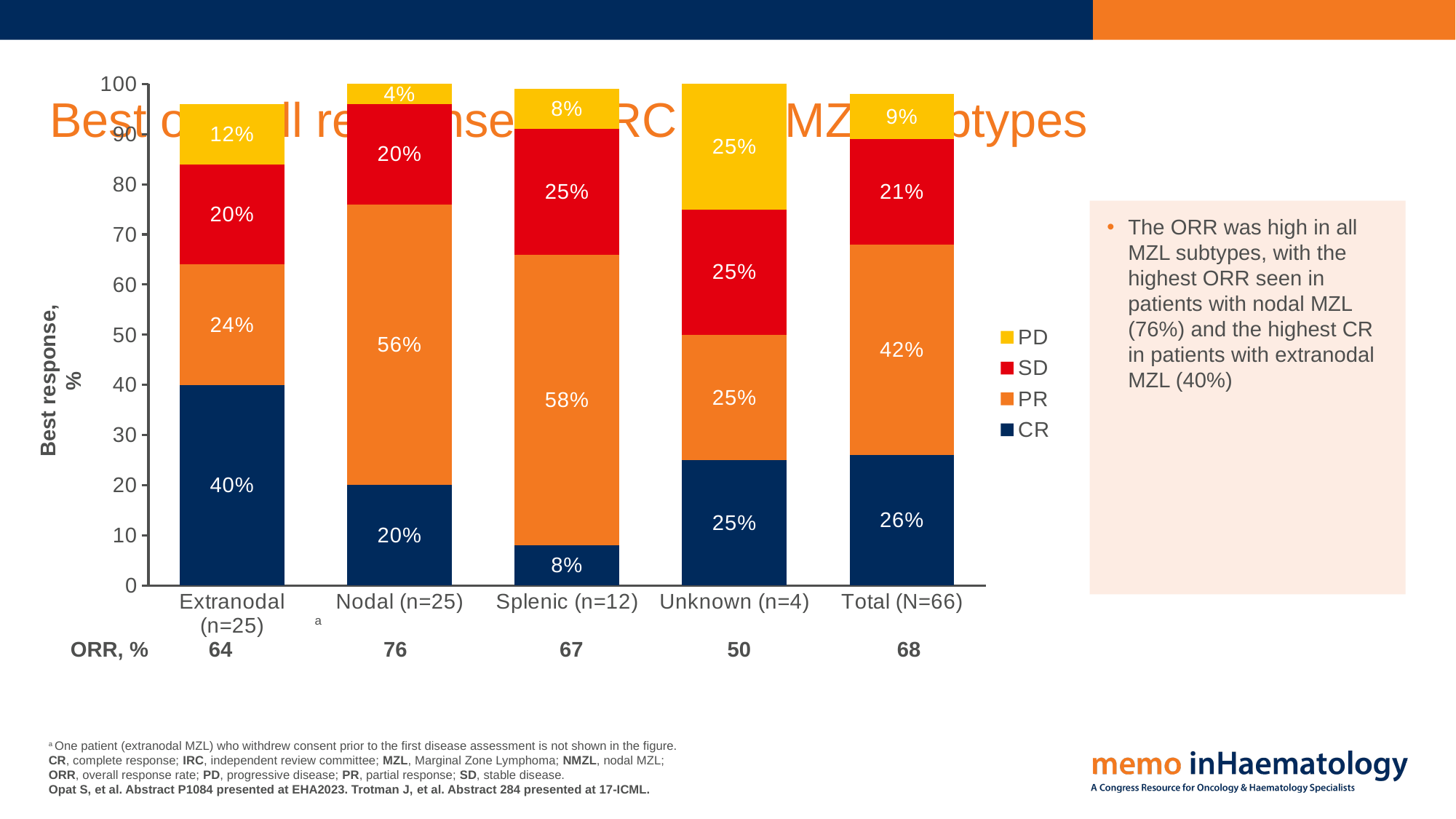
How many series does the legend list? 4 Is the PD value larger for Unknown (n=4) or for Total (N=66)? Unknown (n=4) Which category has the highest CR value? Extranodal (n=25) What is the PD value for Nodal (n=25)? 4% What is the PR value for Splenic (n=12)? 58% What type of chart is shown on the slide? Stacked bar chart Which category has the lowest CR value? Splenic (n=12) Which series is shown in yellow in the legend? PD What is the SD value for Total (N=66)? 21% How many categories are shown on the x axis? 5 What is the difference between the PR value for Nodal (n=25) and the PR value for Extranodal (n=25)? 32% What is the CR value for Extranodal (n=25)? 40%